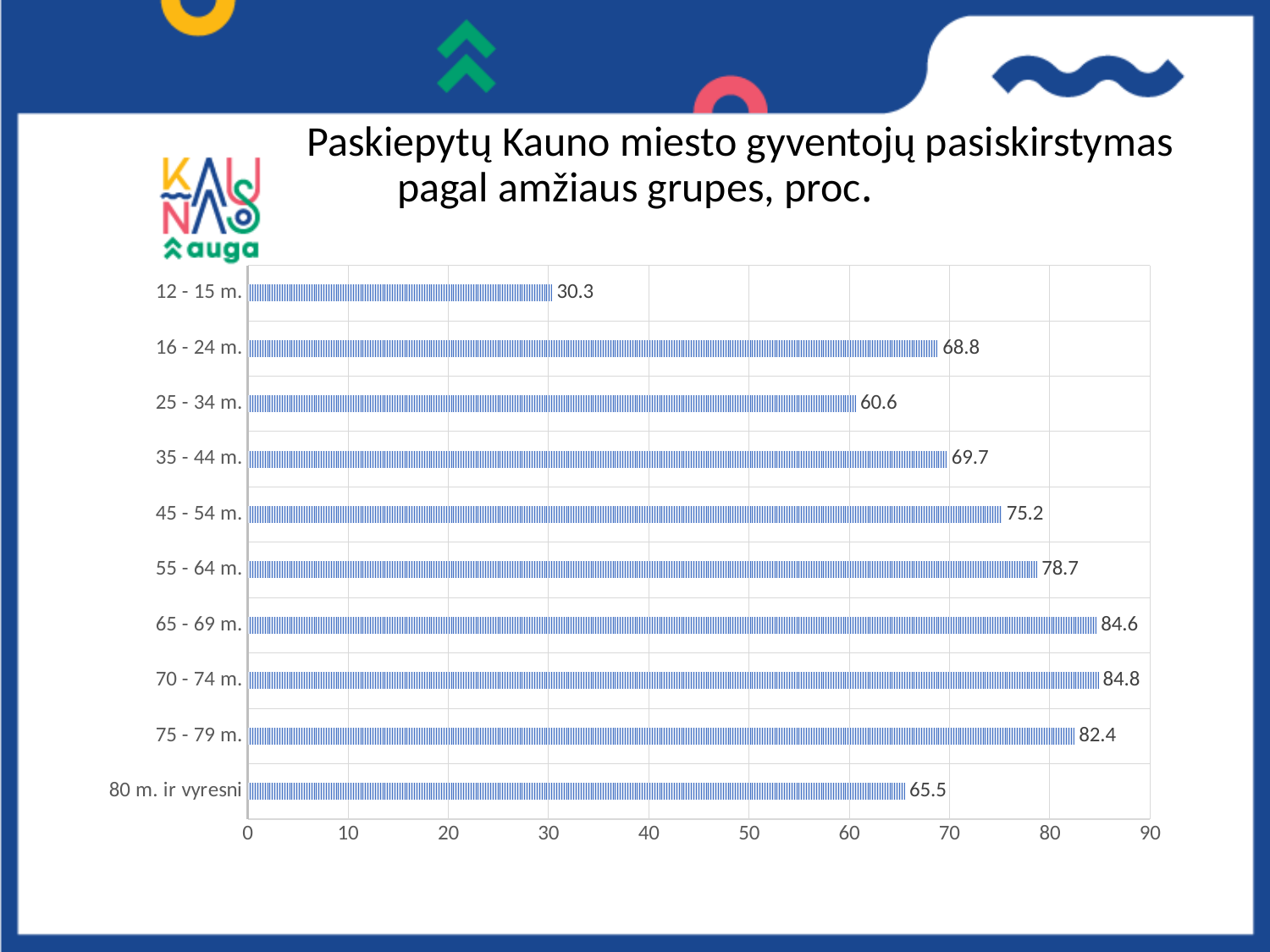
How many age groups are shown in the chart? 10 What is the value for the 55 - 64 m. age group? 78.7 What is the value for the 25 - 34 m. age group? 60.6 Which age group has the lowest value? 12 - 15 m. What is the title of the chart? Paskiepytų Kauno miesto gyventojų pasiskirstymas pagal amžiaus grupes, proc. What is the value for the 12 - 15 m. age group? 30.3 Is the value for 55 - 64 m. greater or less than 70? greater What is the value for the 80 m. ir vyresni age group? 65.5 What is the difference between the values for 45 - 54 m. and 35 - 44 m.? 5.5 Which is larger, the value for 16 - 24 m. or the value for 25 - 34 m.? 16 - 24 m. What type of chart is shown on the slide? bar chart What is the difference between the values for 75 - 79 m. and 80 m. ir vyresni? 16.9